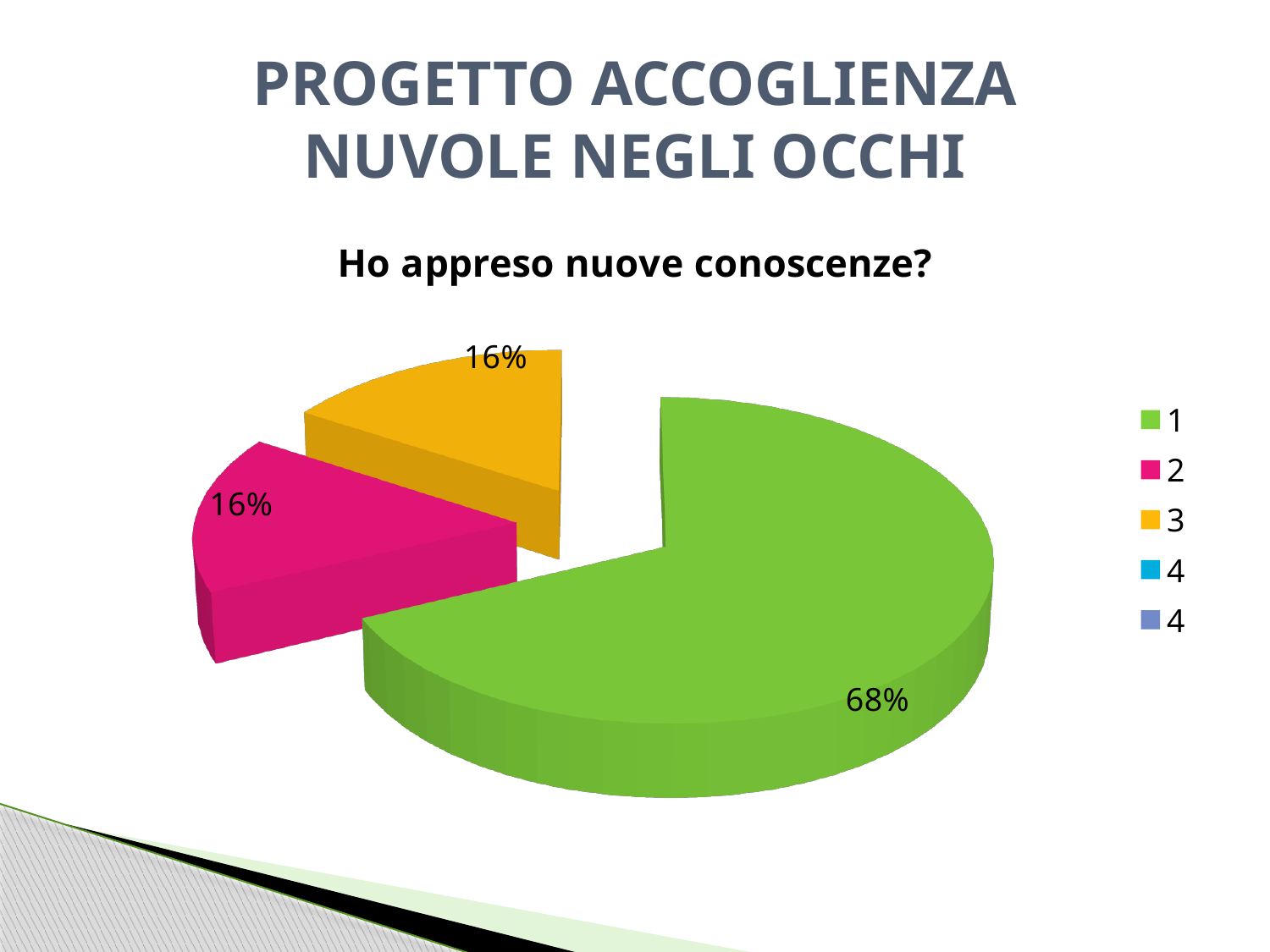
Is the share for category 1 greater or less than 50%? greater How many entries does the legend list? 5 What share of the pie does category 2 have? 16% How many slices are visible in the pie? 3 What colour is the slice for category 1? green What kind of chart is shown on the slide? pie chart What is the difference between the share of category 1 and the share of category 2? 52% What share of the pie does category 3 have? 16% What share of the pie does category 1 have? 68% Which category has the largest slice of the pie? 1 What is the chart's title? Ho appreso nuove conoscenze? Which is larger, the slice for category 1 or the slice for category 3? 1